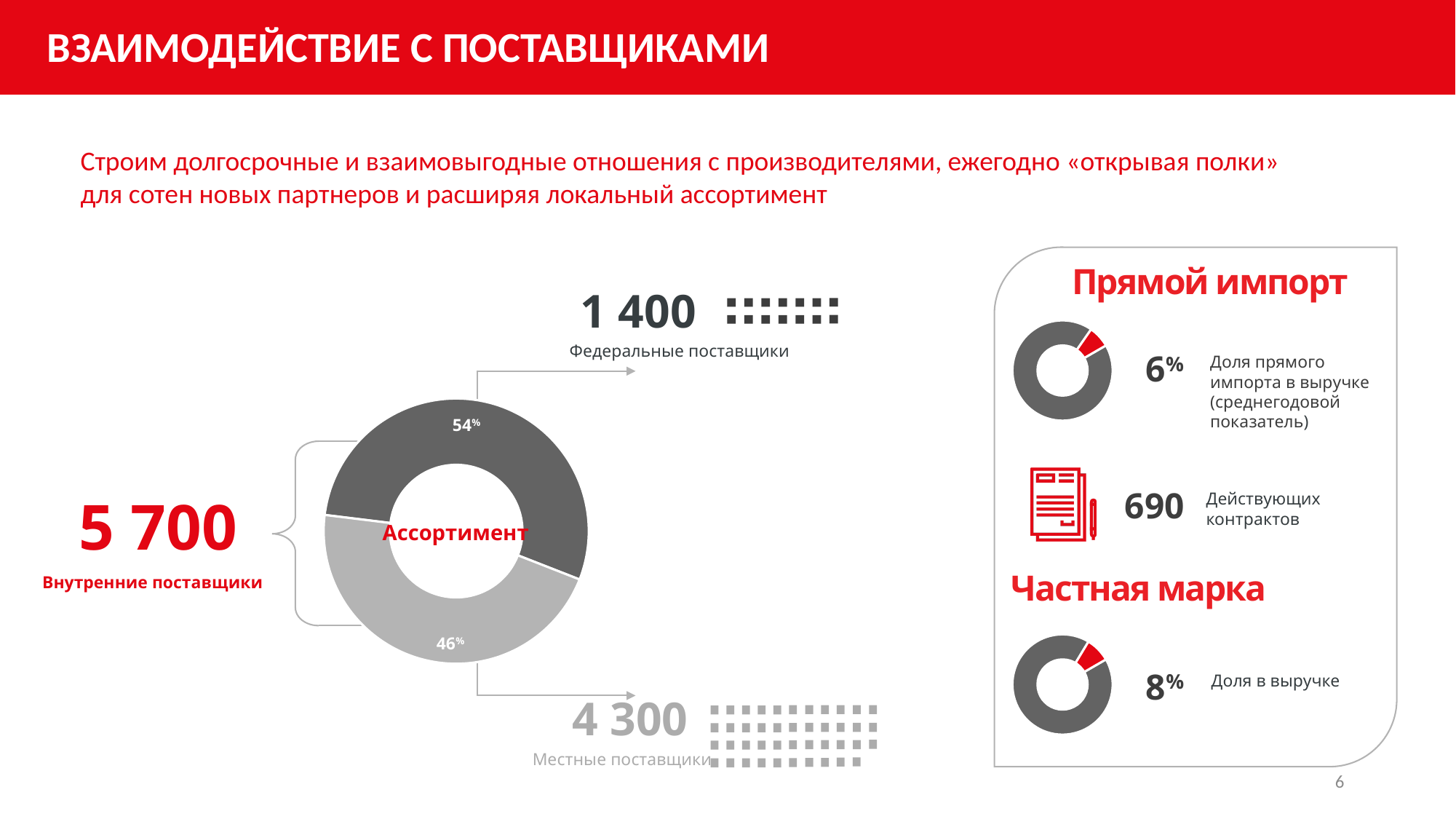
In the «Ассортимент» donut chart, which segment is larger: the dark grey one (Федеральные поставщики) or the light grey one (Местные поставщики)? Dark grey (Федеральные поставщики), 54% What kind of chart is the central chart labelled «Ассортимент»? Pie chart (donut) How many «Местные поставщики» are shown next to the «Ассортимент» chart? 4 300 How many «Федеральные поставщики» are shown next to the «Ассортимент» chart? 1 400 In the «Частная марка» donut chart on the right, what is the share in revenue («Доля в выручке»)? 8% In the «Ассортимент» donut chart, what percentage is shown on the dark grey segment? 54% What is the total number of «Внутренние поставщики» shown to the left of the «Ассортимент» chart? 5 700 How many segments does the «Ассортимент» donut chart have? 2 In the «Ассортимент» donut chart, what is the difference in percentage points between the 54% segment and the 46% segment? 8 percentage points In the «Ассортимент» donut chart, what percentage is shown on the light grey segment? 46% Which is larger: the share shown in the «Прямой импорт» donut or the share shown in the «Частная марка» donut? Частная марка (8%) In the «Прямой импорт» donut chart on the right, what share of revenue does direct import account for? 6%